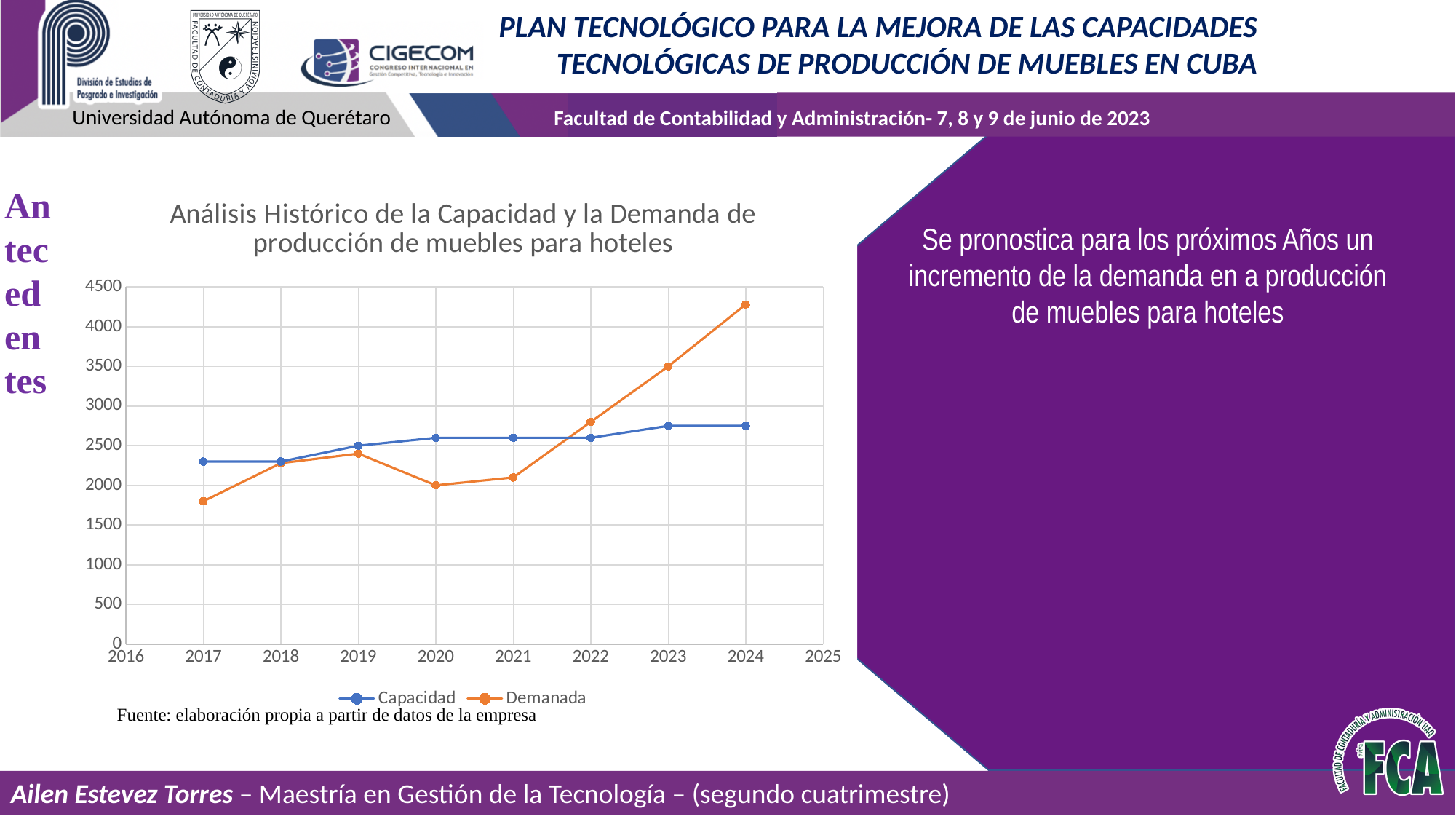
Is the Demanada value for 2024 greater or less than 4000? greater In which year is the Demanada series at its lowest? 2017 Does the Demanada series rise or fall from 2021 to 2024? rise How many years have data points plotted in the chart? 8 How many series does the chart legend list? 2 In 2024, which series has the larger value, Capacidad or Demanada? Demanada Is the Capacidad value for 2024 greater or less than 3000? less What is the Demanada value for 2020? 2000 In which year is the Demanada series at its highest? 2024 Is the Demanada value for 2017 greater or less than 2000? less What is the Demanada value for 2023? 3500 What kind of chart is shown on the slide? line chart